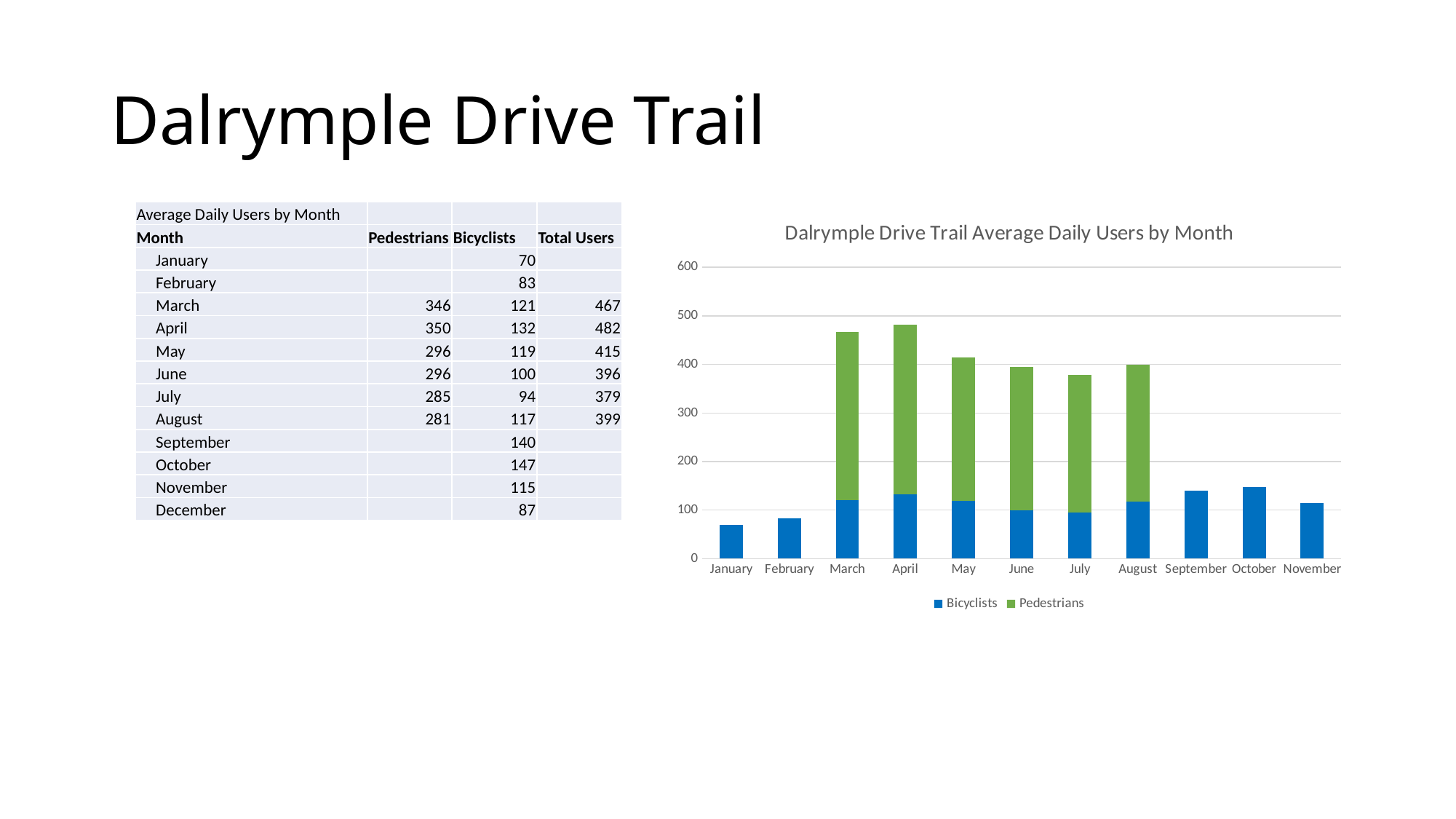
Is the value for Bicyclists in January greater or less than 100? less What kind of chart is shown on the slide? Stacked bar chart What is the title of the chart? Dalrymple Drive Trail Average Daily Users by Month According to the table, what is the total number of users in March? 467 How many months are shown on the x axis of the chart? 11 Is the total height of the April bar greater or less than 400? greater How many series does the chart legend list? 2 According to the table, what is the average daily number of Bicyclists in October? 147 Which is larger in the chart, the Bicyclists bar for September or for November? September What are the two series named in the chart legend? Bicyclists and Pedestrians Using the table values, what is the difference between Bicyclists in October and Bicyclists in January? 77 Which month has the tallest stacked bar in the chart? April